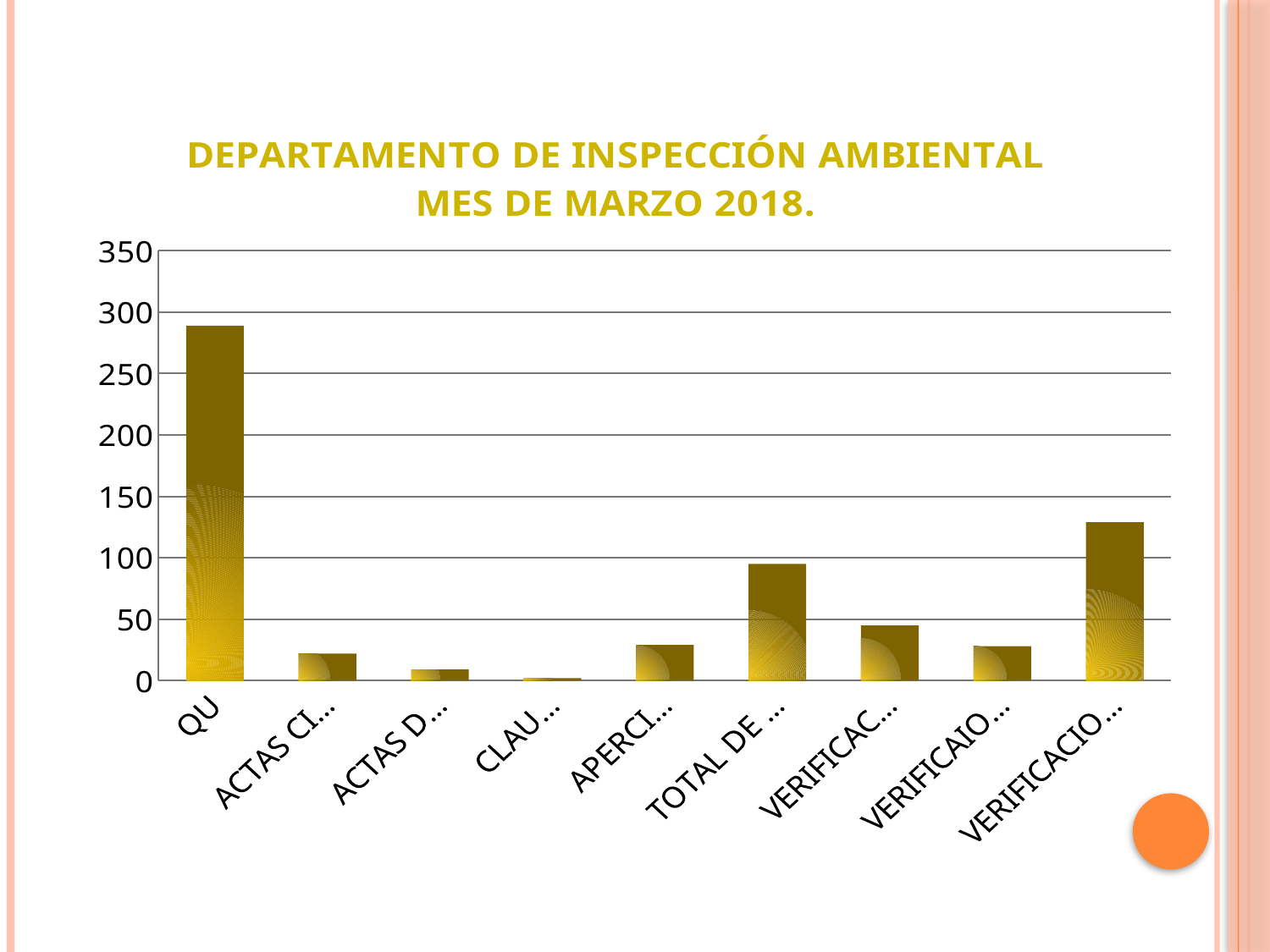
How many bars (categories) are plotted in the chart? 9 What is the highest value shown on the vertical axis? 350 Is the value for QU greater or less than 250? greater Which is larger, the value for TOTAL DE ... or the value for VERIFICAC...? TOTAL DE ... Which category has the lowest bar? CLAU... Is the value for the last bar (VERIFICACIO...) greater or less than 100? greater What is the title of the chart? DEPARTAMENTO DE INSPECCIÓN AMBIENTAL MES DE MARZO 2018. Which is larger, the value for QU or the value for the last bar (VERIFICACIO...)? QU Is the value for CLAU... greater or less than 50? less Which category has the highest bar? QU What kind of chart is shown on the slide? bar chart